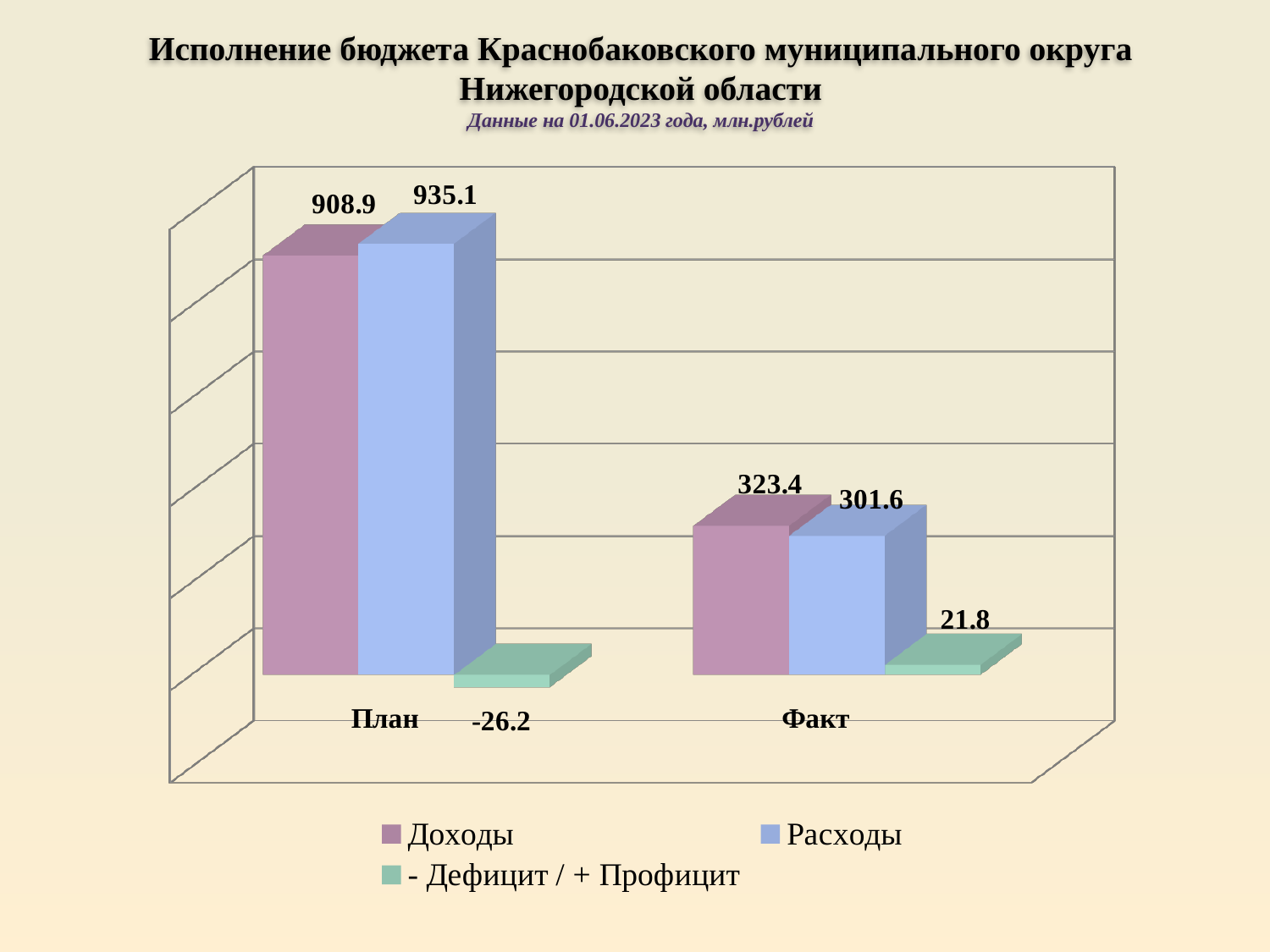
What is the value of the - Дефицит / + Профицит series for План? -26.2 What kind of chart is shown on the slide? Bar chart How many series does the legend list? 3 What units are the data given in, according to the subtitle? млн.рублей For Факт, which is larger: Доходы or Расходы? Доходы Which category has the higher Расходы value, План or Факт? План What is the value of Расходы for Факт? 301.6 What is the difference between Расходы and Доходы for План? 26.2 What is the difference between Доходы for План and Доходы for Факт? 585.5 What is the value of the - Дефицит / + Профицит series for Факт? 21.8 How many categories are shown on the x axis? 2 What is the value of Доходы for План? 908.9